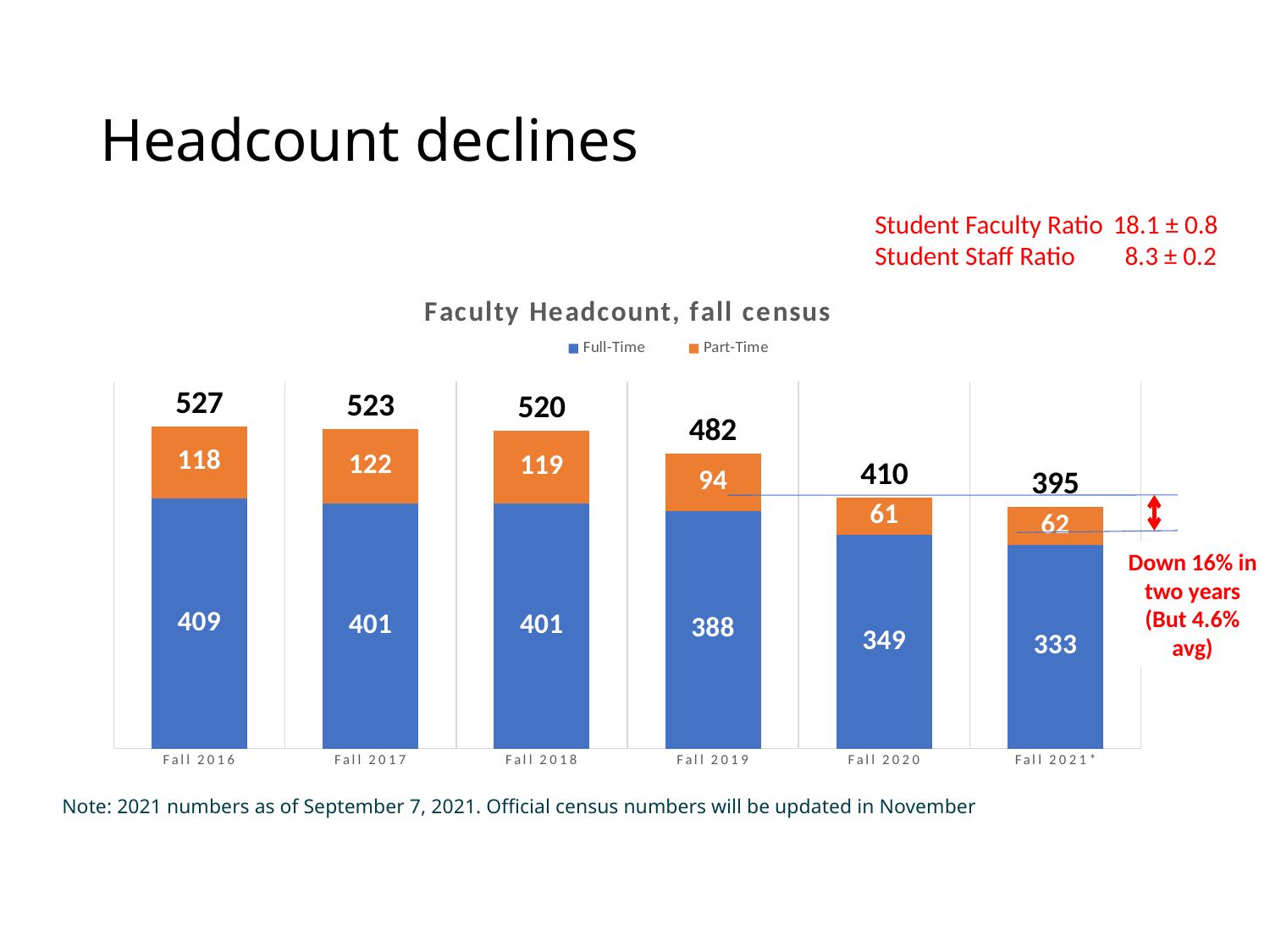
How many series does the legend list? 2 Which fall census has the highest total faculty headcount? Fall 2016 What is the difference in Full-Time faculty headcount between Fall 2016 and Fall 2021*? 76 What is the total faculty headcount for Fall 2020? 410 What is the Part-Time faculty headcount for Fall 2019? 94 Which fall census has the lowest Full-Time faculty headcount? Fall 2021* Does the total faculty headcount rise or fall from Fall 2016 to Fall 2021*? Fall What kind of chart is shown on the slide? Stacked bar chart Which is larger, the Part-Time headcount for Fall 2017 or for Fall 2018? Fall 2017 What is the title of the chart? Faculty Headcount, fall census What is the Full-Time faculty headcount for Fall 2016? 409 How many fall census periods are shown on the x axis? 6